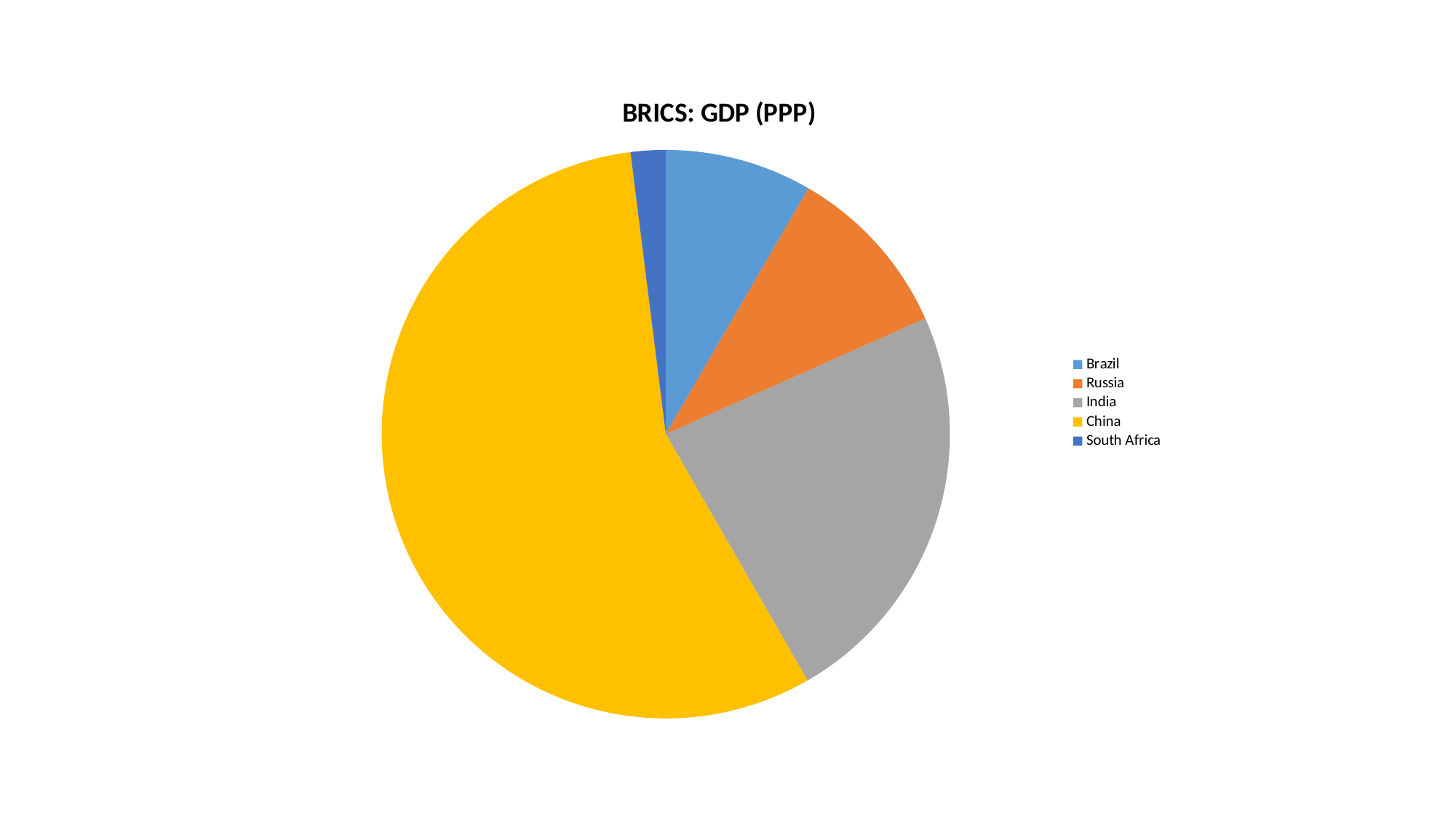
What kind of chart is shown on the slide? pie chart How many entries does the legend list? 5 What is the title of the chart? BRICS: GDP (PPP) Which country has the largest slice of the pie? China Does China's slice account for more or less than half of the pie? more What colour is the slice for China? yellow Which country has the second-largest slice of the pie? India Which slice is larger, Brazil or South Africa? Brazil Which slice is larger, China or India? China Which slice is larger, India or Russia? India Which country has the smallest slice of the pie? South Africa How many slices does the pie chart have? 5